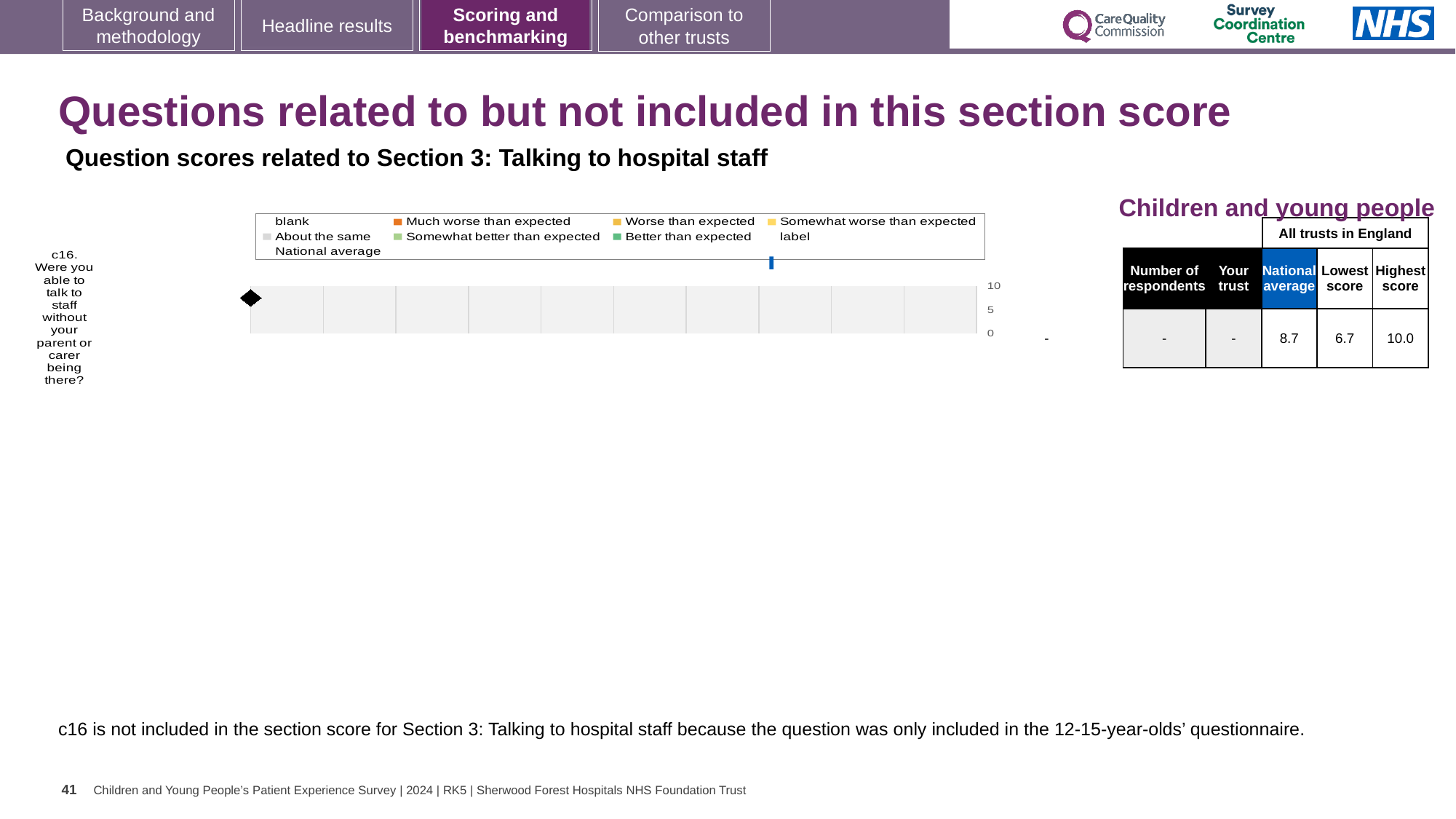
What is the highest value shown on the chart's value axis? 10 What is the difference between the highest score and the lowest score for c16 in the table? 3.3 In the table next to the chart, what is the lowest score across all trusts in England for c16? 6.7 In the table next to the chart, what is the national average score for c16? 8.7 In the table next to the chart, what is the highest score across all trusts in England for c16? 10.0 What kind of chart is shown for question c16? bar chart Is the national average score for c16 greater or less than 5? greater How many question categories are plotted on the chart? 1 Which is larger for c16 in the table, the national average or the lowest score? National average Which question is plotted on the chart? c16. Were you able to talk to staff without your parent or carer being there?